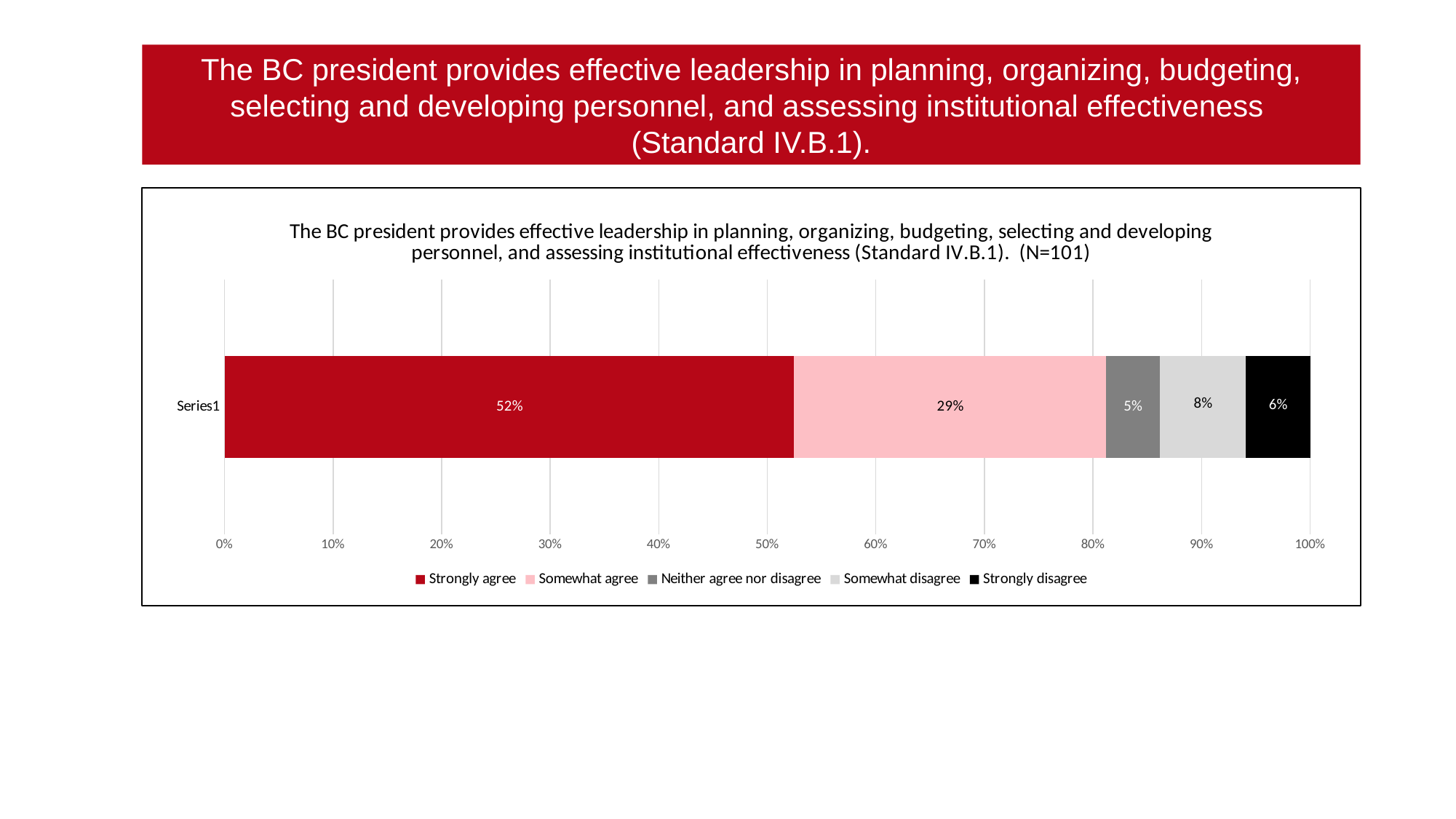
Which response category has the lowest percentage? Neither agree nor disagree What is the sample size (N) stated in the chart title? 101 What percentage of respondents selected "Somewhat agree"? 29% How many series does the legend list? 5 What percentage of respondents selected "Strongly agree"? 52% Which is larger, the percentage for "Somewhat disagree" or for "Strongly disagree"? Somewhat disagree What percentage of respondents selected "Strongly disagree"? 6% What kind of chart is shown on the slide? Stacked bar chart What is the difference in percentage points between "Strongly agree" and "Somewhat agree"? 23 What percentage of respondents selected "Somewhat disagree"? 8% What percentage of respondents selected "Neither agree nor disagree"? 5% Which response category has the highest percentage? Strongly agree